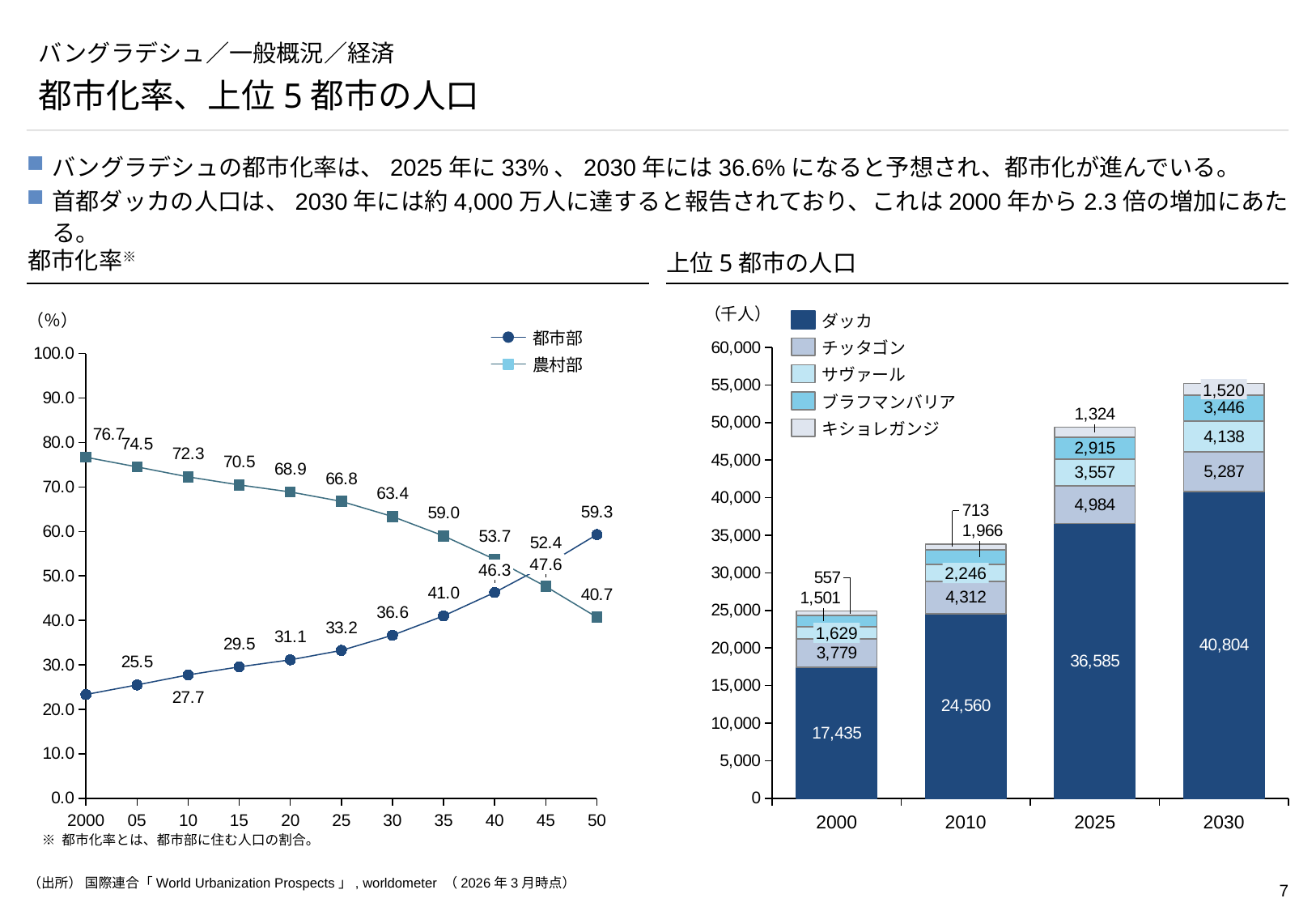
In the 都市化率 chart, does the 農村部 series rise or fall from 2000 to 2050? fall In the 都市化率 chart, what is the difference between the 農村部 and 都市部 values in 2040? 7.4 How many series does the legend of the 上位5都市の人口 chart list? 5 In the 上位5都市の人口 chart, what is the total of the stacked bar for 2000? 24,901 How many series does the legend of the 都市化率 chart list? 2 In the 都市化率 chart, what is the 農村部 value for 2000? 76.7 In the 上位5都市の人口 chart, what is the difference between the ダッカ values for 2030 and 2000? 23,369 In the 都市化率 chart, what is the 都市部 value for 2030? 36.6 What kind of chart is the 上位5都市の人口 chart? stacked bar chart In the 都市化率 chart, which series has the larger value in 2050, 都市部 or 農村部? 都市部 In the 都市化率 chart, what is the 都市部 value for 2050? 59.3 In the 上位5都市の人口 chart, what is the value for ダッカ in 2025? 36,585